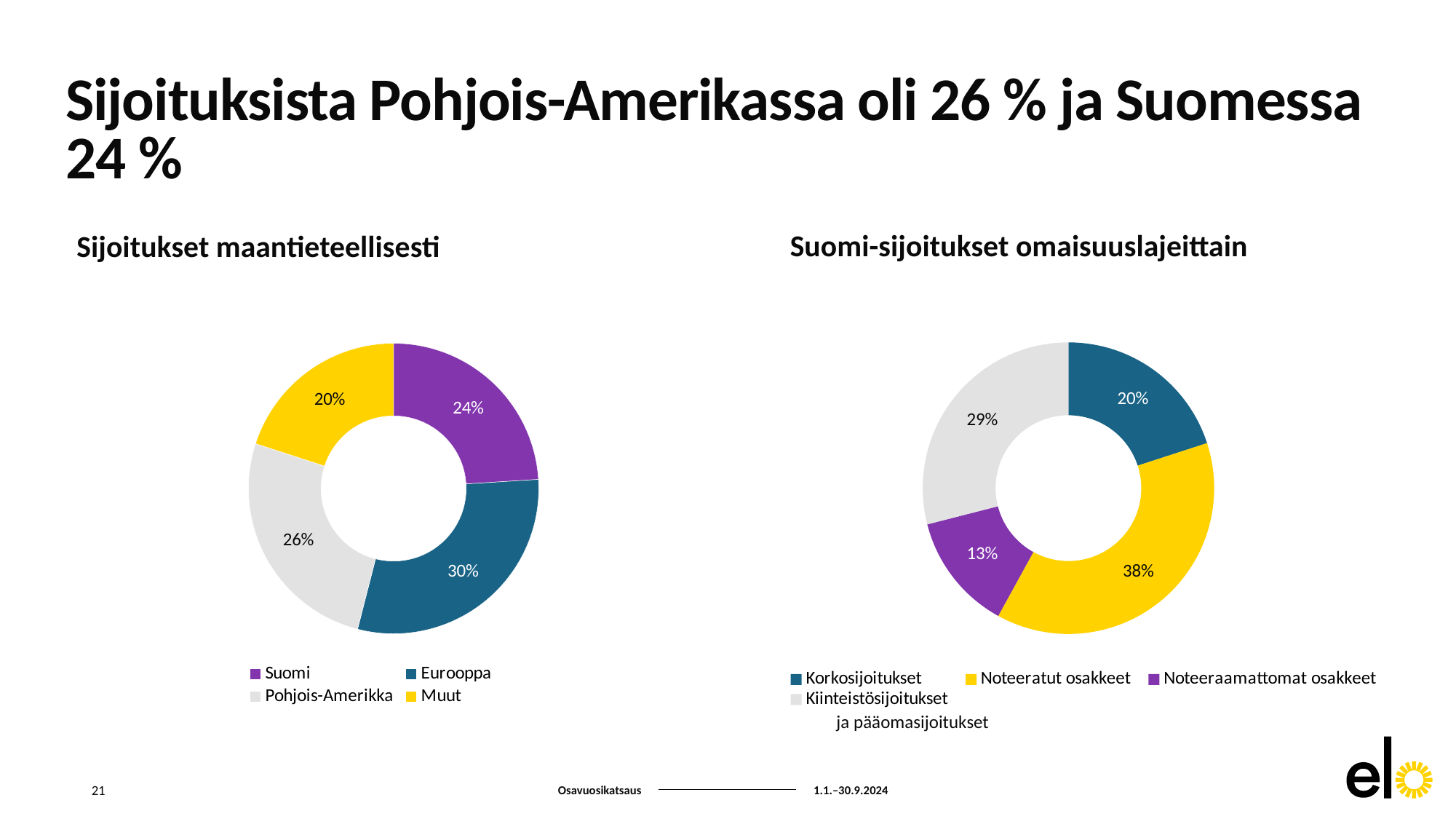
In the 'Suomi-sijoitukset omaisuuslajeittain' chart, what is the difference between Noteeratut osakkeet and Korkosijoitukset? 18% In the 'Suomi-sijoitukset omaisuuslajeittain' chart, which is larger: Korkosijoitukset or Kiinteistösijoitukset ja pääomasijoitukset? Kiinteistösijoitukset ja pääomasijoitukset In the 'Sijoitukset maantieteellisesti' chart, what share is Pohjois-Amerikka? 26% In the 'Sijoitukset maantieteellisesti' chart, what is the difference between the Eurooppa and Suomi shares? 6% In the 'Sijoitukset maantieteellisesti' chart, what share is Eurooppa? 30% In the 'Suomi-sijoitukset omaisuuslajeittain' chart, which category has the smallest share? Noteeraamattomat osakkeet In the 'Sijoitukset maantieteellisesti' chart, which category has the smallest share? Muut In the 'Suomi-sijoitukset omaisuuslajeittain' chart, what share is Noteeratut osakkeet? 38% What type of chart is 'Suomi-sijoitukset omaisuuslajeittain'? Doughnut (pie) chart In the 'Sijoitukset maantieteellisesti' chart, which category has the largest share? Eurooppa In the 'Suomi-sijoitukset omaisuuslajeittain' chart, what share is Noteeraamattomat osakkeet? 13% In the 'Sijoitukset maantieteellisesti' chart, how many categories are shown? 4